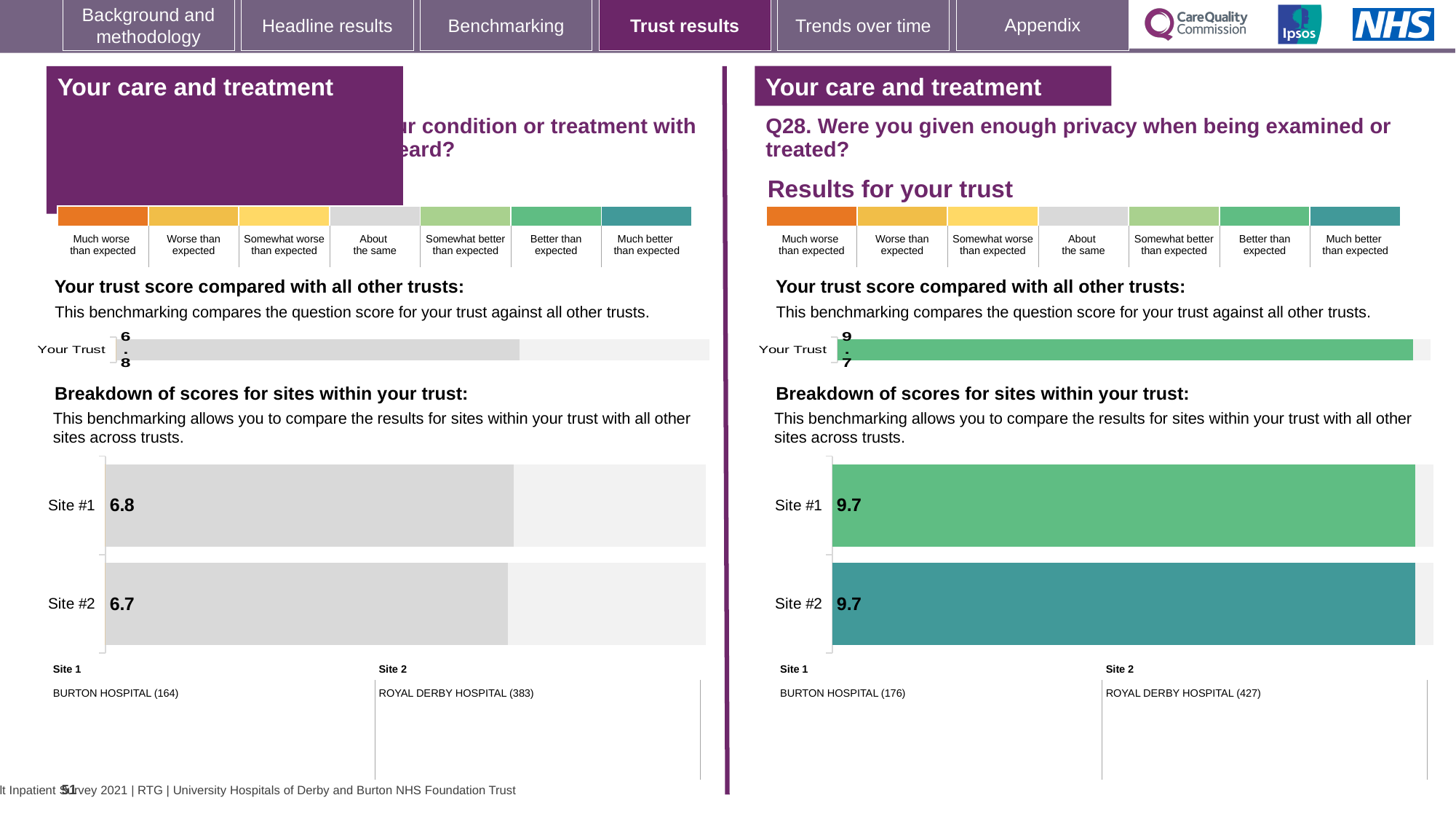
On the right-hand panel (Q28) site breakdown chart, what is the score for Site #2? 9.7 On the right-hand panel (Q28) 'Your trust score compared with all other trusts' chart, what is the score for Your Trust? 9.7 What type of chart is used for the site breakdown on the left-hand panel? Bar chart On the left-hand panel's 'Your trust score compared with all other trusts' chart, what is the score for Your Trust? 6.8 On the left-hand panel's site breakdown chart, which site has the higher score? Site #1 On the right-hand panel (Q28) site breakdown chart, what is the difference between the Site #1 and Site #2 scores? 0 On the right-hand panel (Q28) site breakdown chart, what is the score for Site #1? 9.7 On the left-hand panel's site breakdown chart, what is the score for Site #1? 6.8 On the left-hand panel's site breakdown chart, what is the score for Site #2? 6.7 On the left-hand panel's site breakdown chart, what is the difference between the Site #1 and Site #2 scores? 0.1 Which hospital is listed as Site 2 on the right-hand panel (Q28)? ROYAL DERBY HOSPITAL (427) How many sites are shown in the site breakdown chart on the right-hand panel (Q28)? 2